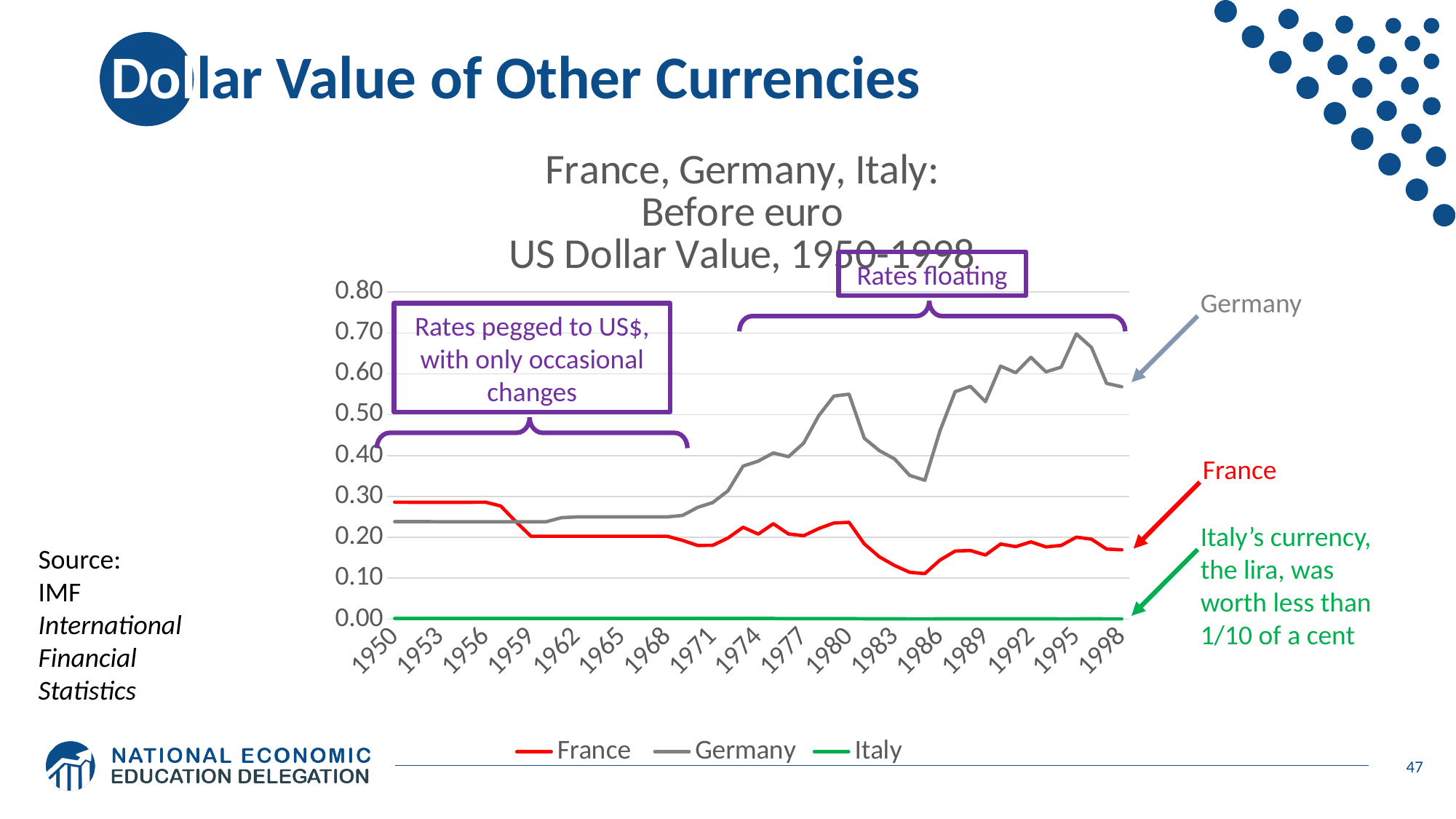
What colour is the Germany line in the chart? grey In 1950, which is larger, the value for France or the value for Germany? France Which series are listed in the chart legend? France, Germany, Italy Does the Germany line generally rise or fall from 1950 to 1998? rise Which series reaches the highest value on the chart? Germany In 1998, which is larger, the value for Germany or the value for France? Germany What kind of chart is shown on the slide? line chart Is the value for Germany in 1950 greater or less than 0.30? less Which series has the lowest values throughout the chart? Italy How many series does the legend list? 3 Is the value for Germany in 1995 greater or less than 0.60? greater Is the value for France in 1986 greater or less than 0.20? less